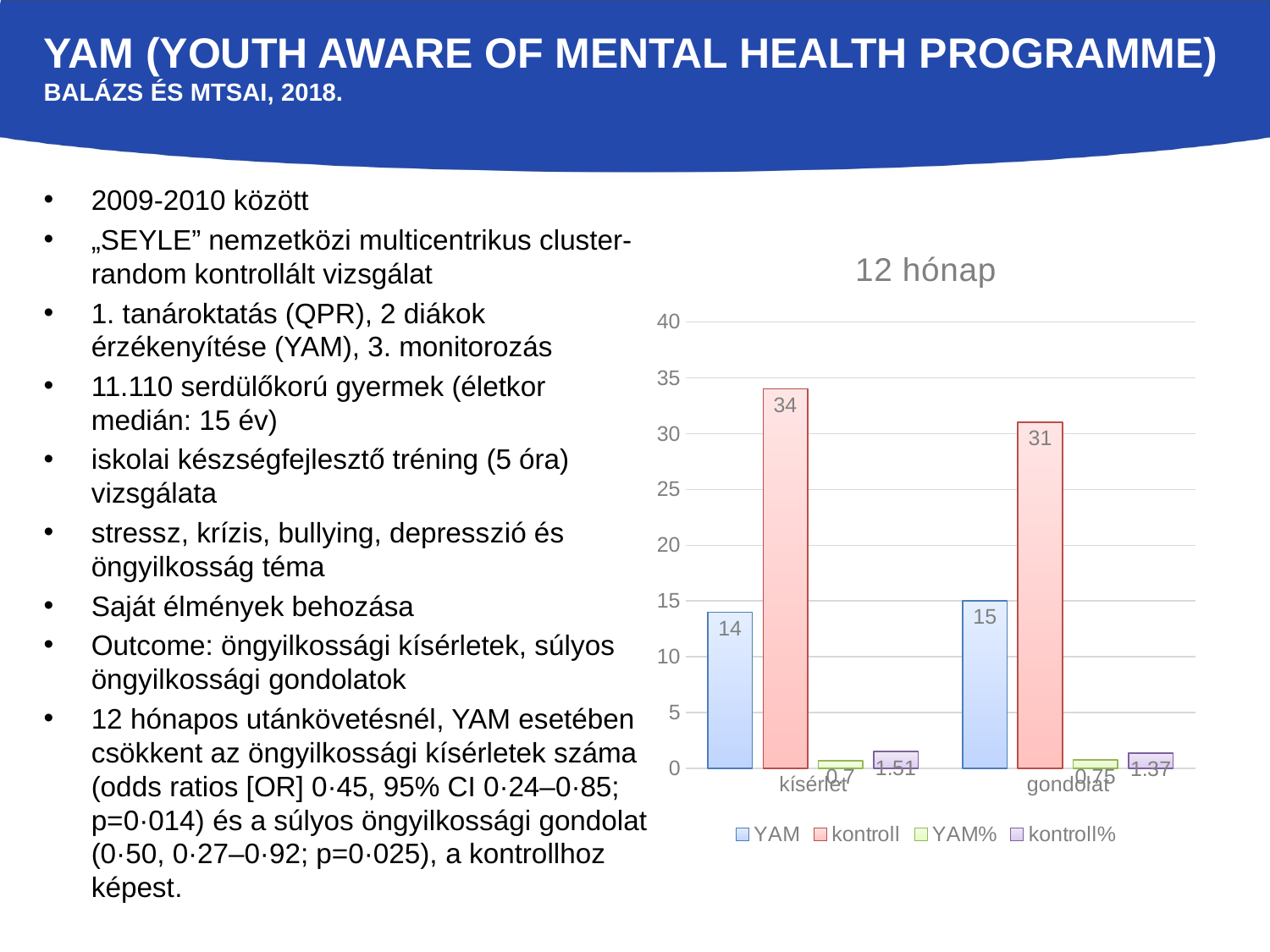
What is the value of the kontroll% series for kísérlet? 1.51 What is the difference between the kontroll and YAM values for kísérlet? 20 What is the title of the chart? 12 hónap Is the YAM value for kísérlet greater or less than 20? less Which is larger, the kontroll value for kísérlet or the kontroll value for gondolat? kísérlet What type of chart is shown on the slide? bar chart Which series has the highest value for the gondolat category? kontroll What is the value of the YAM series for gondolat? 15 How many categories are shown on the x axis of the chart? 2 How many series does the chart legend list? 4 What is the value of the kontroll% series for gondolat? 1.37 What is the value of the kontroll series for kísérlet? 34